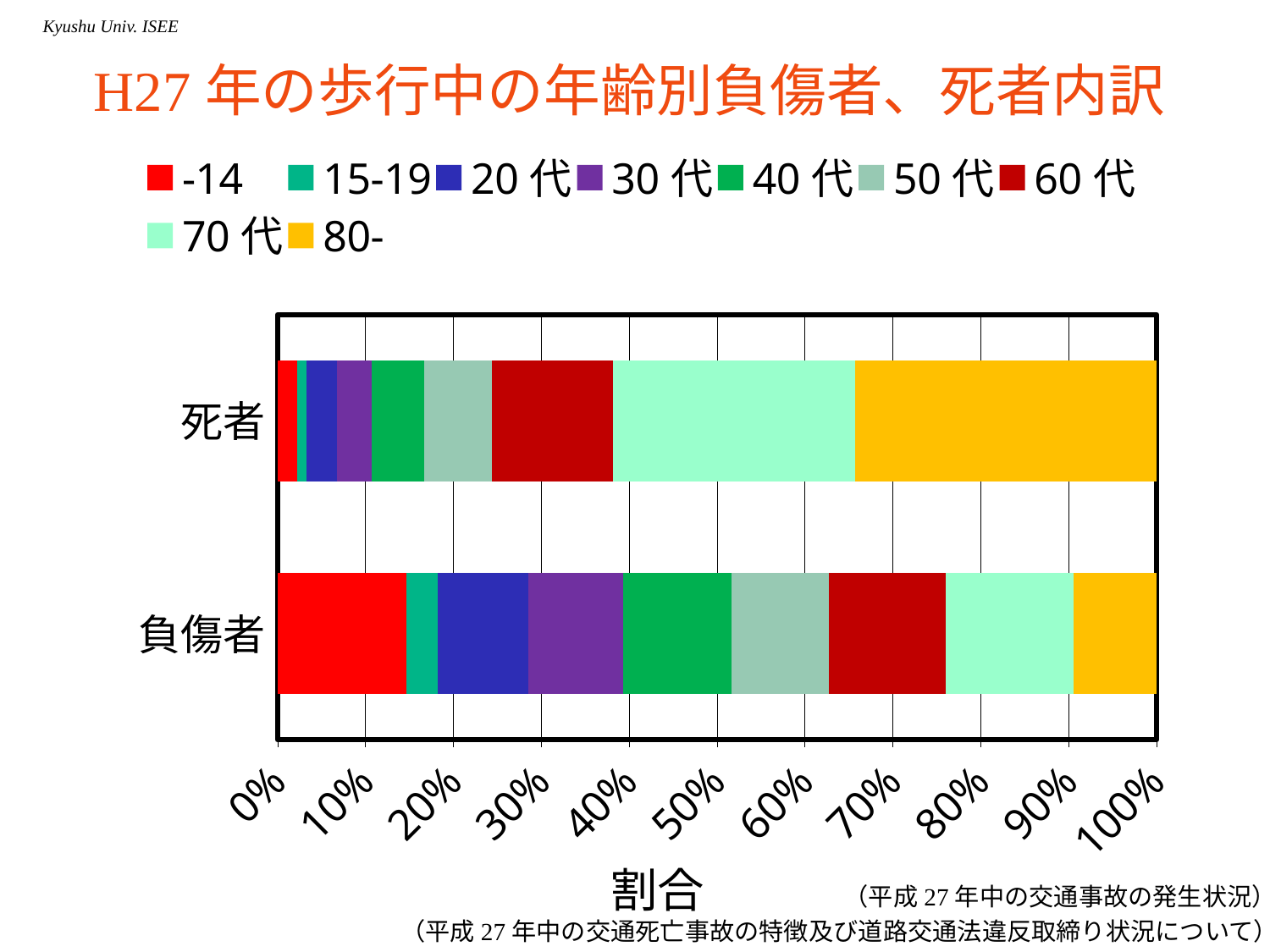
How many series does the legend list? 9 Is the share of -14 in the 負傷者 bar greater or less than 10%? greater Is the share of -14 larger in the 死者 bar or the 負傷者 bar? 負傷者 What is the title of the chart on the slide? H27年の歩行中の年齢別負傷者、死者内訳 Which age group has the smallest share in the 負傷者 bar? 15-19 What kind of chart is shown on the slide? stacked bar chart Which age group has the largest share in the 死者 bar? 80- How many categories (bars) does the chart show? 2 Is the share of 80- larger in the 死者 bar or the 負傷者 bar? 死者 Is the share of 70代 in the 死者 bar greater or less than 20%? greater What is the label of the horizontal axis? 割合 Which age group has the smallest share in the 死者 bar? 15-19